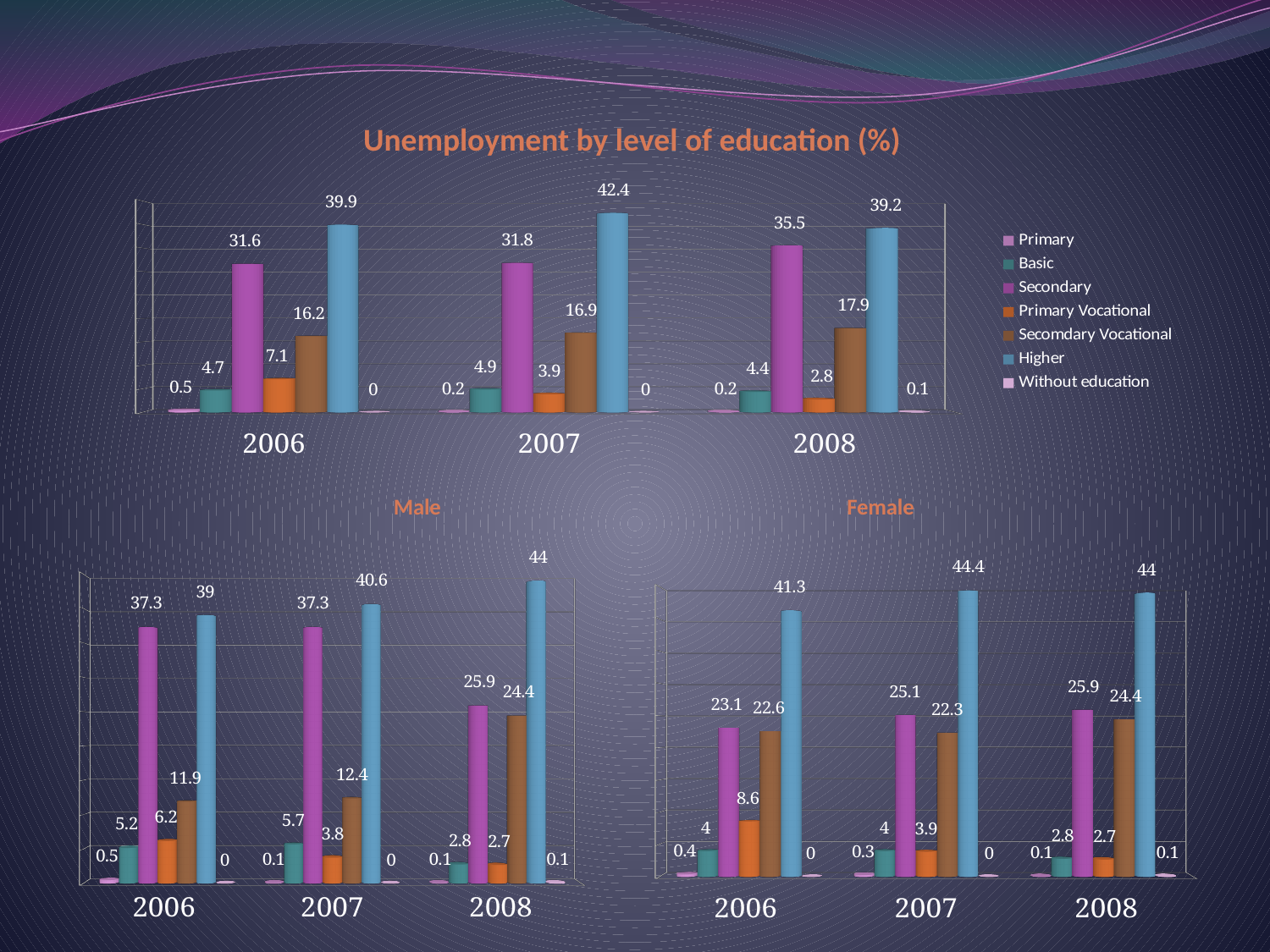
In the top chart titled 'Unemployment by level of education (%)', what is the value for Secondary in 2008? 35.5 In the top chart titled 'Unemployment by level of education (%)', what is the value for Higher in 2007? 42.4 In the top chart titled 'Unemployment by level of education (%)', what is the difference between the Secondary Vocational values for 2008 and 2006? 1.7 What kind of chart is the 'Male' chart? bar chart In the 'Male' chart, what is the value for Higher in 2008? 44 How many series does the legend of the top chart list? 7 In the 'Female' chart, what is the value for Primary Vocational in 2006? 8.6 In the 'Male' chart, how does the Higher value change from 2006 to 2008? rises In the 'Female' chart, what is the difference between the Higher values for 2007 and 2006? 3.1 In the 'Male' chart, which year has the lowest value for Secondary? 2008 In the 'Female' chart, which is larger in 2007: Secondary or Secondary Vocational? Secondary In the top chart titled 'Unemployment by level of education (%)', which year has the highest value for Higher? 2007